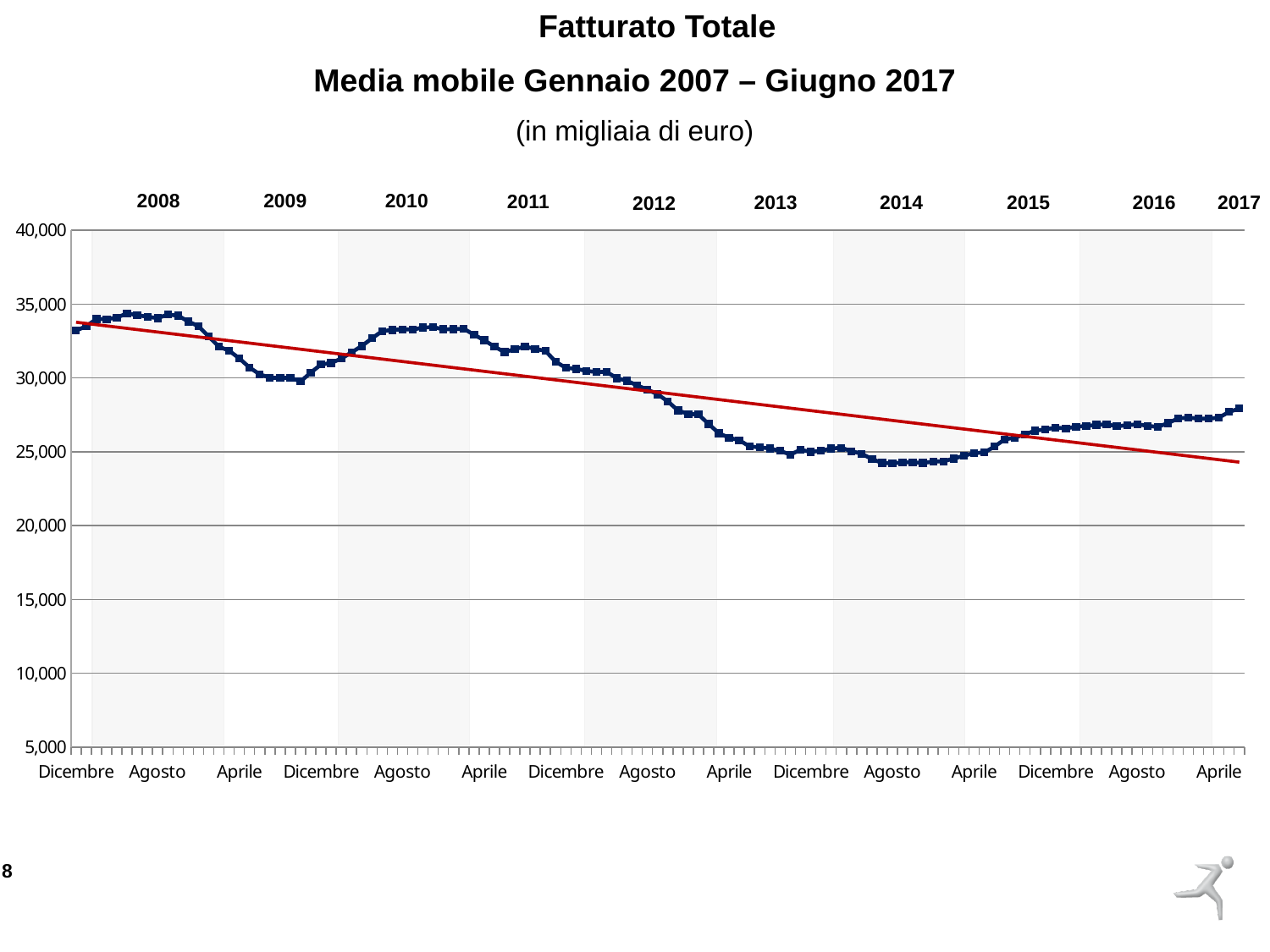
Which is higher, the moving average value at Agosto 2008 or at Agosto 2014? Agosto 2008 Overall, does the moving average line rise or fall from Dicembre 2007 to Aprile 2017? fall Is the moving average value at Dicembre 2007 greater or less than 30,000? greater What is the highest value shown on the vertical axis? 40,000 Is the moving average value at Agosto 2010 greater or less than 30,000? greater Does the red trend line rise or fall across the chart? fall Is the moving average value at Aprile 2017 greater or less than 30,000? less What kind of chart is shown on the slide? line chart In what unit are the values on the chart expressed, according to the subtitle? in migliaia di euro